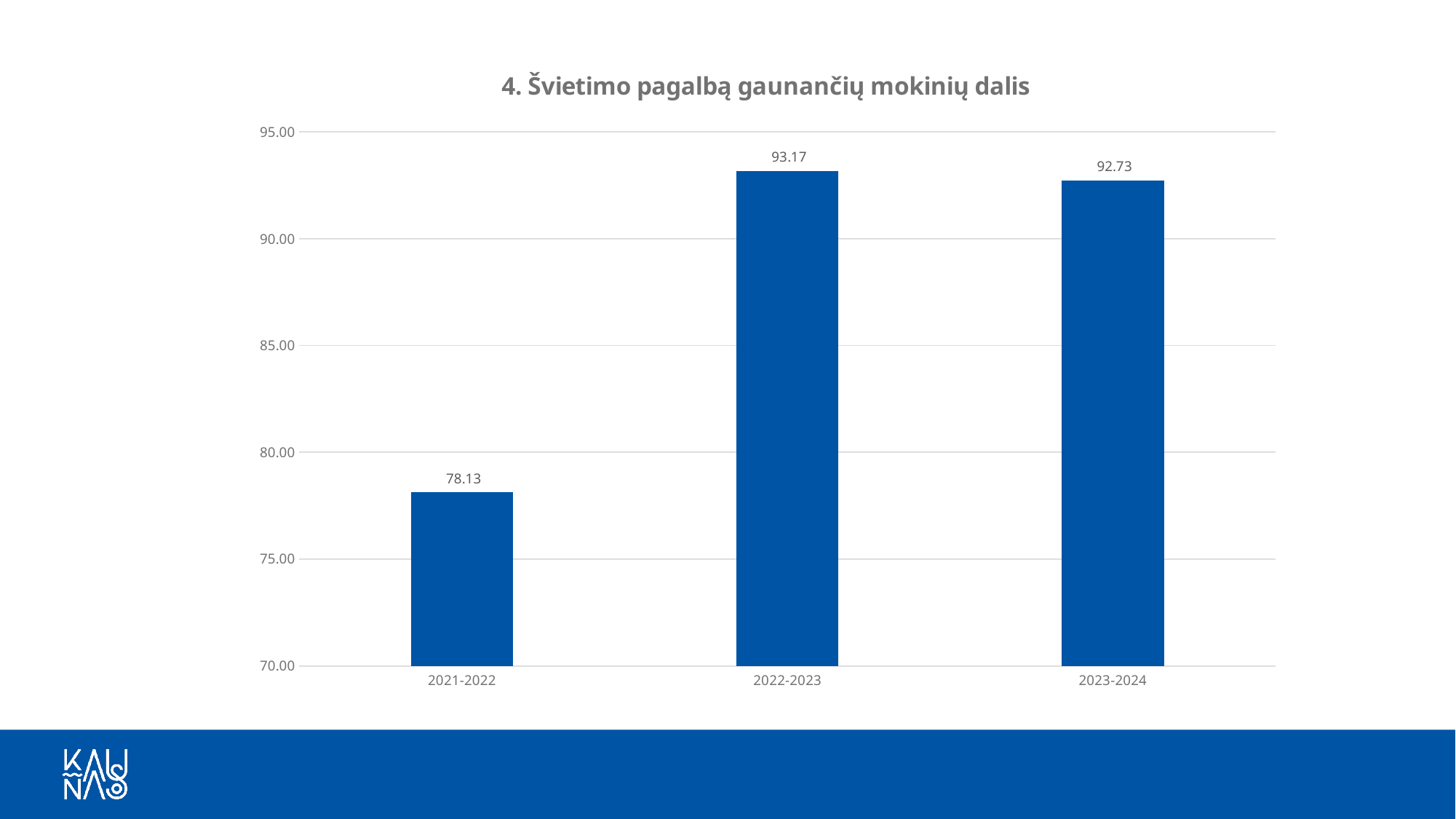
Which is larger, the value for 2021-2022 or the value for 2023-2024? 2023-2024 What is the title of the chart? 4. Švietimo pagalbą gaunančių mokinių dalis What is the value for 2023-2024? 92.73 How many categories are shown on the x axis? 3 What is the difference between the values for 2022-2023 and 2021-2022? 15.04 Is the value for 2021-2022 greater or less than 80.00? less Which category has the lowest value? 2021-2022 Which category has the highest value? 2022-2023 What is the value for 2022-2023? 93.17 What is the value for 2021-2022? 78.13 What kind of chart is shown on the slide? bar chart What is the difference between the values for 2022-2023 and 2023-2024? 0.44